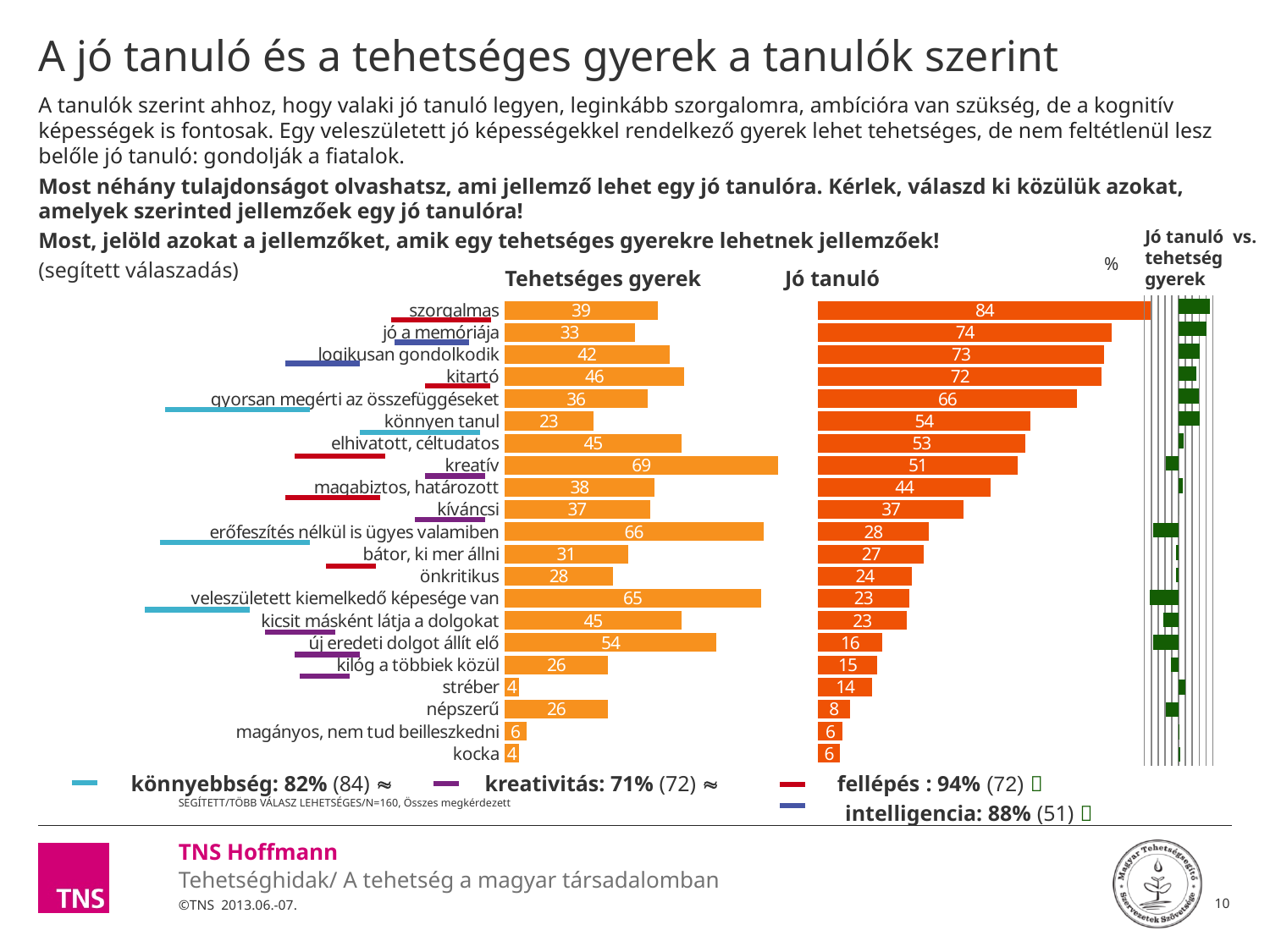
In the "Jó tanuló" chart, which category has the highest value? szorgalmas In the "Tehetséges gyerek" chart, what is the difference between the values for "kreatív" and "kitartó"? 23 In the "Jó tanuló" chart, what is the difference between the values for "szorgalmas" and "jó a memóriája"? 10 In the "Jó tanuló" chart, what is the value for "könnyen tanul"? 54 In the "Tehetséges gyerek" chart, which category has the highest value? kreatív In the "Tehetséges gyerek" chart, what is the value for "új eredeti dolgot állít elő"? 54 What kind of chart is the "Jó tanuló" chart? bar chart In the "Tehetséges gyerek" chart, what is the value for "kreatív"? 69 In the "Jó tanuló" chart, what is the value for "szorgalmas"? 84 In the "Jó tanuló" chart, which is larger: the value for "kreatív" or the value for "kíváncsi"? kreatív Which is larger: the value for "erőfeszítés nélkül is ügyes valamiben" in the "Tehetséges gyerek" chart or in the "Jó tanuló" chart? Tehetséges gyerek How many categories are listed in the "Tehetséges gyerek" chart? 21